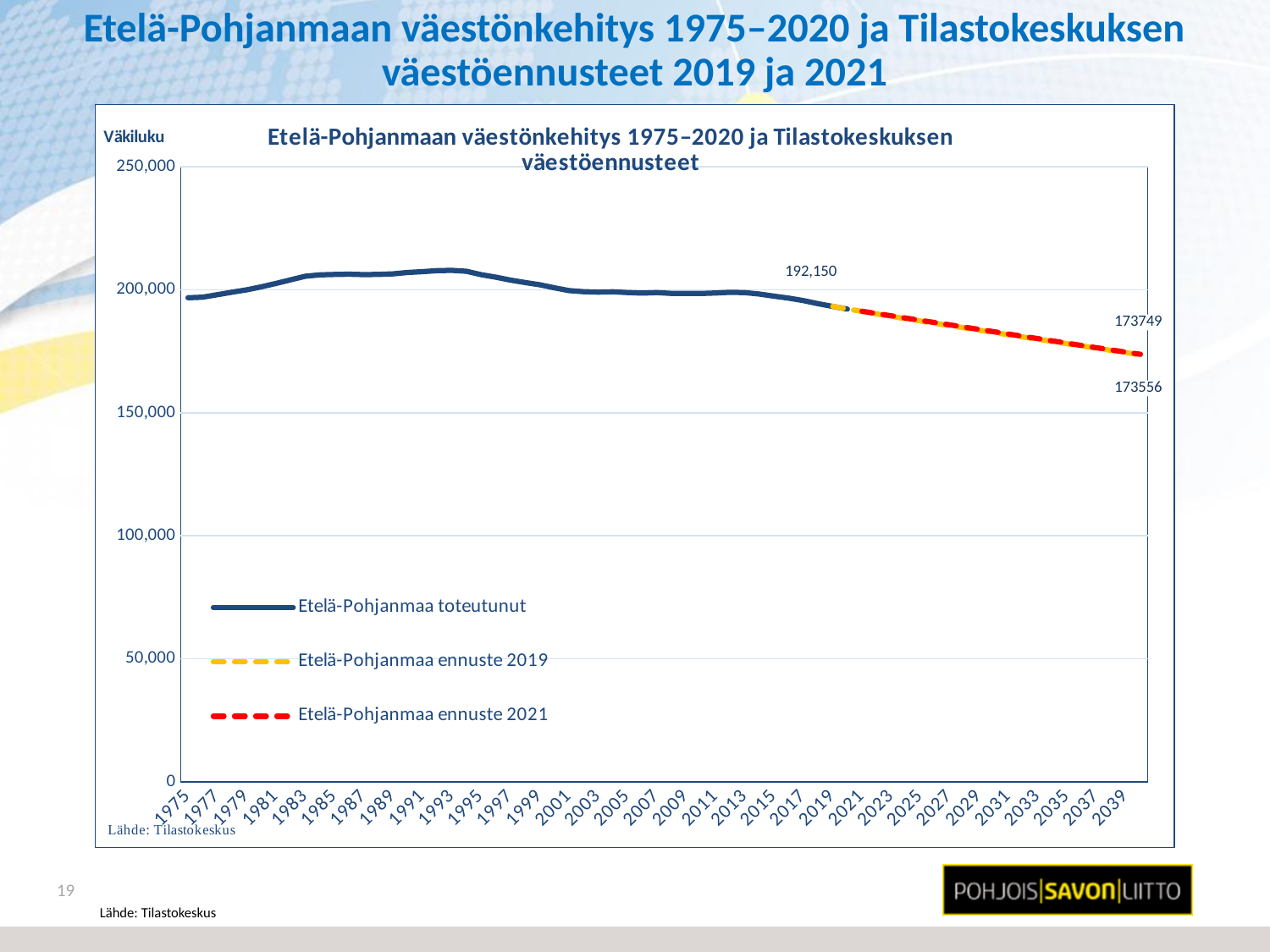
Is the forecast value for 2039 greater or less than 150,000? greater What is the label on the vertical axis of the chart? Väkiluku Does the Etelä-Pohjanmaa toteutunut line rise or fall from 1975 to 1993? rise Do the forecast lines rise or fall from 2021 to 2039? fall What value is printed at the end of the Etelä-Pohjanmaa toteutunut line? 192,150 What kind of chart is shown on the slide? line chart What is the difference between the two values printed at the right end of the forecast lines (173749 and 173556)? 193 How many series does the chart legend list? 3 Is the value for Etelä-Pohjanmaa toteutunut in 1993 greater or less than 200,000? greater What colour is the Etelä-Pohjanmaa ennuste 2021 line in the legend? red Is the value for Etelä-Pohjanmaa toteutunut in 1975 greater or less than 200,000? less Which is larger: the value 192,150 printed at the end of the actual line or the value 173749 printed at the end of the forecast? 192,150